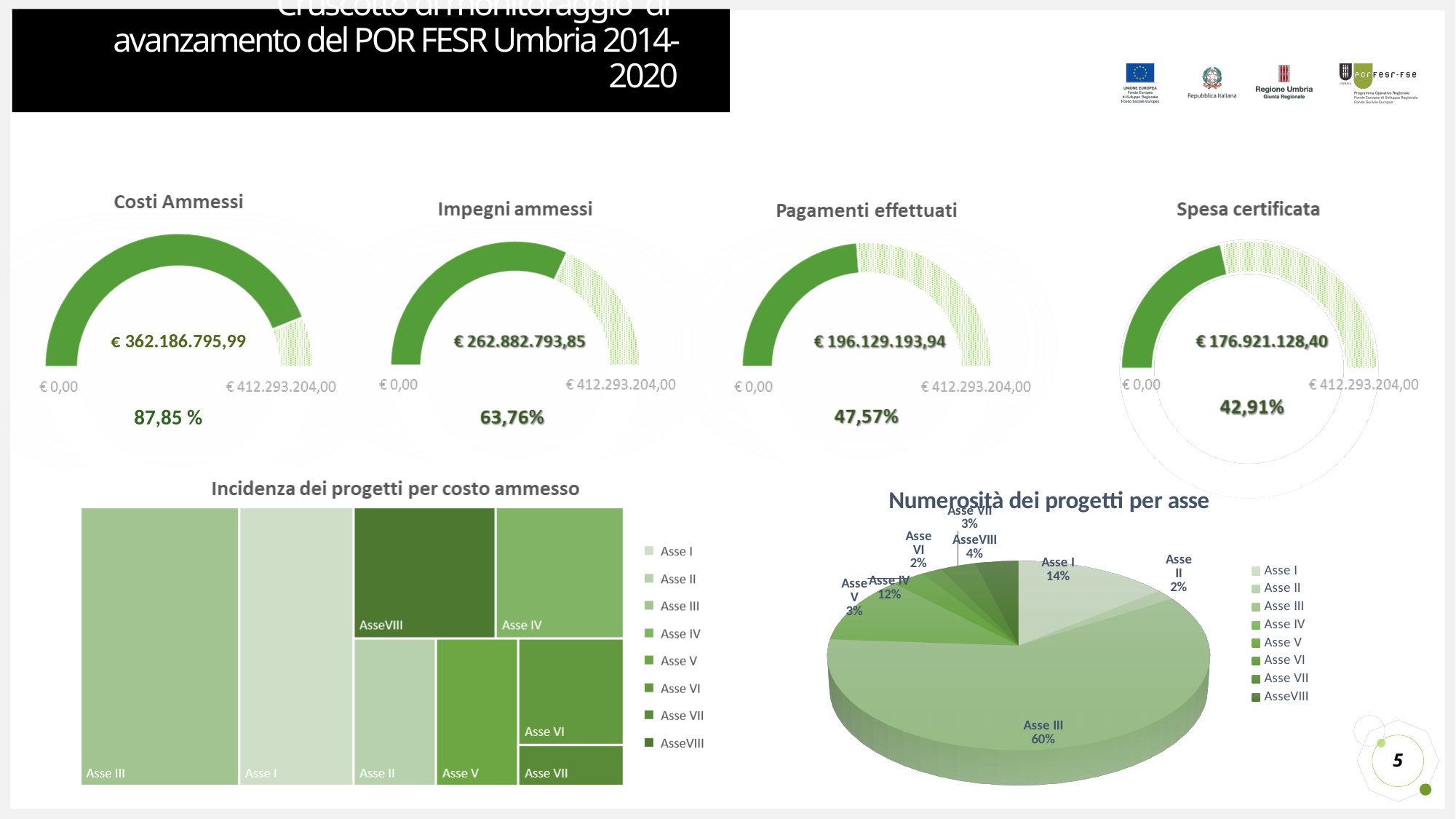
In the 'Impegni ammessi' gauge chart, what is the maximum value shown on the gauge scale? € 412.293.204,00 Which of the four gauge charts at the top of the slide shows the highest percentage? Costi Ammessi In the 'Spesa certificata' gauge chart, what percentage is shown? 42,91% In the 'Costi Ammessi' gauge chart, what value is shown? € 362.186.795,99 In the 'Numerosità dei progetti per asse' pie chart, what is the difference in percentage points between Asse I and Asse II? 12 In the 'Numerosità dei progetti per asse' pie chart, what share does Asse IV have? 12% How many entries does the legend of the 'Numerosità dei progetti per asse' pie chart list? 8 Which of the four gauge charts at the top of the slide shows the lowest percentage? Spesa certificata In the 'Pagamenti effettuati' gauge chart, what value is shown? € 196.129.193,94 In the 'Numerosità dei progetti per asse' pie chart, which is larger, Asse VIII or Asse VII? Asse VIII In the 'Incidenza dei progetti per costo ammesso' chart, which Asse occupies the largest area? Asse III In the 'Numerosità dei progetti per asse' pie chart, what share does Asse III have? 60%